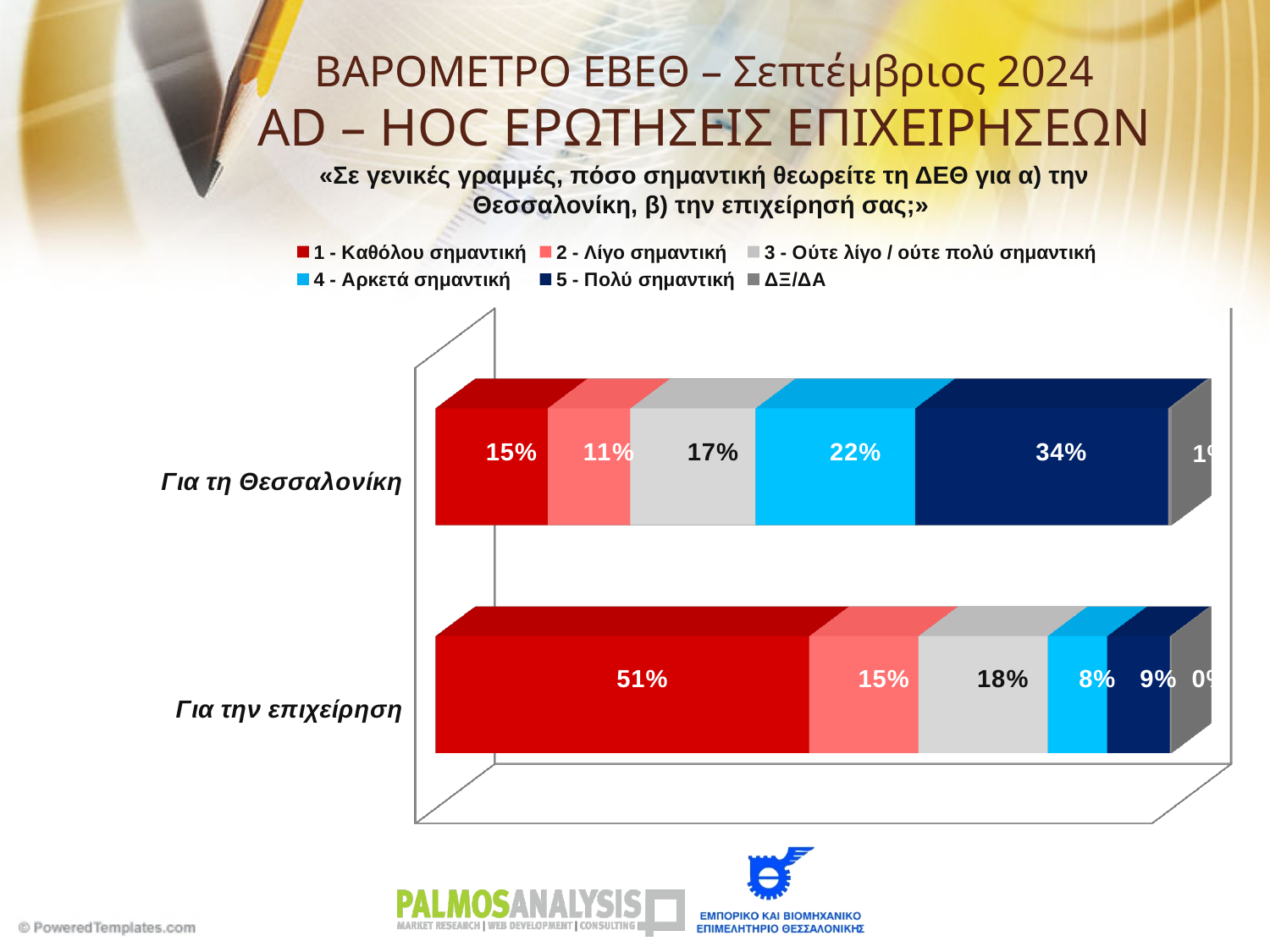
Which segment is the largest in the "Για τη Θεσσαλονίκη" bar? 5 - Πολύ σημαντική Which bar has the larger value for "4 - Αρκετά σημαντική", "Για τη Θεσσαλονίκη" or "Για την επιχείρηση"? Για τη Θεσσαλονίκη What is the value for "5 - Πολύ σημαντική" in the "Για τη Θεσσαλονίκη" bar? 34% How many series does the legend list? 6 What is the value for "3 - Ούτε λίγο / ούτε πολύ σημαντική" in the "Για την επιχείρηση" bar? 18% Which segment is the largest in the "Για την επιχείρηση" bar? 1 - Καθόλου σημαντική What is the value for "2 - Λίγο σημαντική" in the "Για τη Θεσσαλονίκη" bar? 11% What is the difference between the "1 - Καθόλου σημαντική" values for "Για την επιχείρηση" and "Για τη Θεσσαλονίκη"? 36% What is the value for "1 - Καθόλου σημαντική" in the "Για την επιχείρηση" bar? 51% What kind of chart is shown on the slide? stacked bar chart How many categories (bars) are plotted in the chart? 2 What is the value for "4 - Αρκετά σημαντική" in the "Για τη Θεσσαλονίκη" bar? 22%